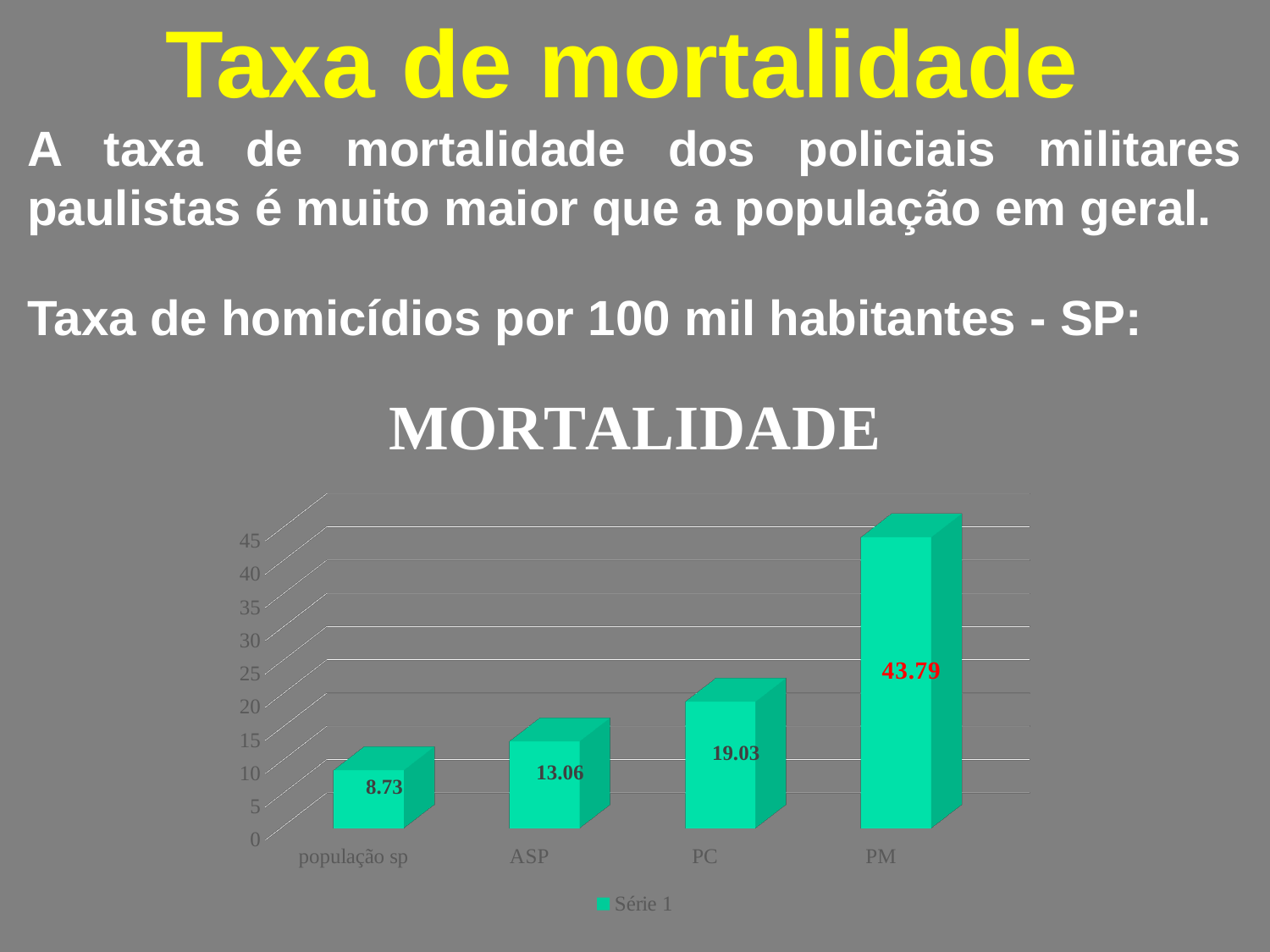
What is the difference between the values for PM and população sp? 35.06 What kind of chart is shown? bar chart What is the value for população sp? 8.73 Which category has the highest value? PM What is the value for PM? 43.79 Is the value for PM greater or less than 40? greater What is the value for ASP? 13.06 How many categories are shown on the x axis? 4 Which category has the lowest value? população sp What is the title of the chart? MORTALIDADE Which is larger, the value for PC or the value for ASP? PC What is the value for PC? 19.03